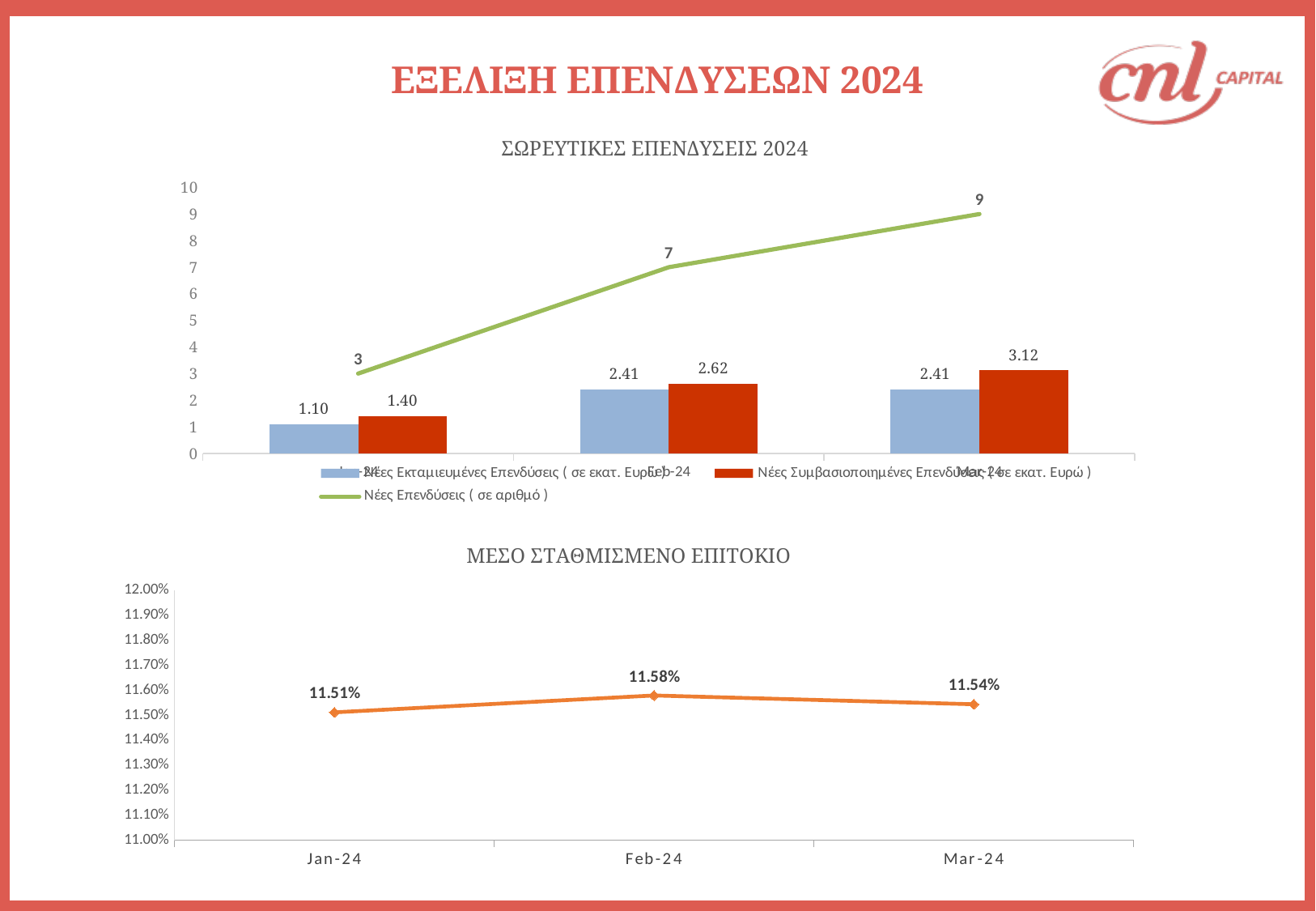
In the chart titled ΣΩΡΕΥΤΙΚΕΣ ΕΠΕΝΔΥΣΕΙΣ 2024, what is the difference between the Νέες Συμβασιοποιημένες Επενδύσεις values for Mar-24 and Feb-24? 0.50 In the chart titled ΣΩΡΕΥΤΙΚΕΣ ΕΠΕΝΔΥΣΕΙΣ 2024, does the Νέες Επενδύσεις (σε αριθμό) line rise or fall from Jan-24 to Mar-24? rise In the chart titled ΜΕΣΟ ΣΤΑΘΜΙΣΜΕΝΟ ΕΠΙΤΟΚΙΟ, how many data points are plotted? 3 In the chart titled ΣΩΡΕΥΤΙΚΕΣ ΕΠΕΝΔΥΣΕΙΣ 2024, which is larger for Feb-24: Νέες Εκταμιευμένες Επενδύσεις or Νέες Συμβασιοποιημένες Επενδύσεις? Νέες Συμβασιοποιημένες Επενδύσεις What kind of chart is the one titled ΜΕΣΟ ΣΤΑΘΜΙΣΜΕΝΟ ΕΠΙΤΟΚΙΟ? line chart In the chart titled ΣΩΡΕΥΤΙΚΕΣ ΕΠΕΝΔΥΣΕΙΣ 2024, what is the value of Νέες Εκταμιευμένες Επενδύσεις for Jan-24? 1.10 In the chart titled ΣΩΡΕΥΤΙΚΕΣ ΕΠΕΝΔΥΣΕΙΣ 2024, what is the value of the Νέες Επενδύσεις (σε αριθμό) line for Feb-24? 7 In the chart titled ΣΩΡΕΥΤΙΚΕΣ ΕΠΕΝΔΥΣΕΙΣ 2024, which month has the highest value for Νέες Συμβασιοποιημένες Επενδύσεις? Mar-24 In the chart titled ΣΩΡΕΥΤΙΚΕΣ ΕΠΕΝΔΥΣΕΙΣ 2024, what is the value of Νέες Συμβασιοποιημένες Επενδύσεις for Mar-24? 3.12 In the chart titled ΜΕΣΟ ΣΤΑΘΜΙΣΜΕΝΟ ΕΠΙΤΟΚΙΟ, what is the value for Feb-24? 11.58% How many series does the legend of the chart titled ΣΩΡΕΥΤΙΚΕΣ ΕΠΕΝΔΥΣΕΙΣ 2024 list? 3 In the chart titled ΜΕΣΟ ΣΤΑΘΜΙΣΜΕΝΟ ΕΠΙΤΟΚΙΟ, which month has the lowest value? Jan-24